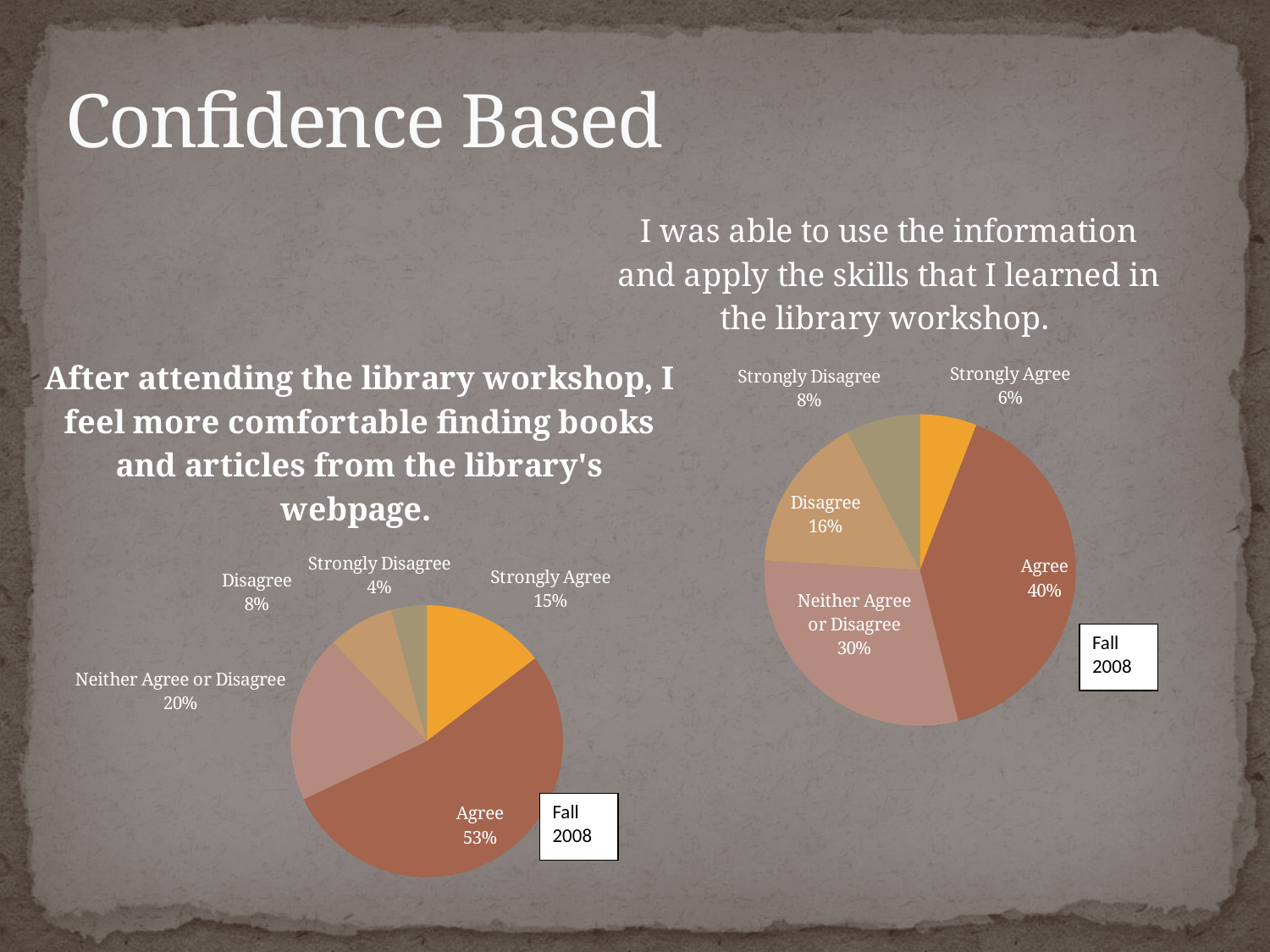
In the right pie chart (use the information and apply the skills), what percentage chose Strongly Agree? 6% What type of chart is used on the left of the slide? Pie chart Which is larger in the left pie chart (finding books and articles from the library's webpage): Neither Agree or Disagree or Disagree? Neither Agree or Disagree How many slices does the right pie chart (use the information and apply the skills) have? 5 In the right pie chart (use the information and apply the skills), what percentage of respondents chose Neither Agree or Disagree? 30% In the left pie chart (finding books and articles from the library's webpage), what is the difference between the Strongly Agree and Strongly Disagree shares? 11% In the right pie chart (use the information and apply the skills), what is the difference between the Agree and Disagree shares? 24% In the left pie chart (finding books and articles from the library's webpage), which response has the smallest share? Strongly Disagree What semester label appears in the legend box next to each pie chart? Fall 2008 In the left pie chart (finding books and articles from the library's webpage), which response has the largest share? Agree In the right pie chart (use the information and apply the skills), which response has the largest share? Agree In the left pie chart (finding books and articles from the library's webpage), what percentage of respondents chose Agree? 53%